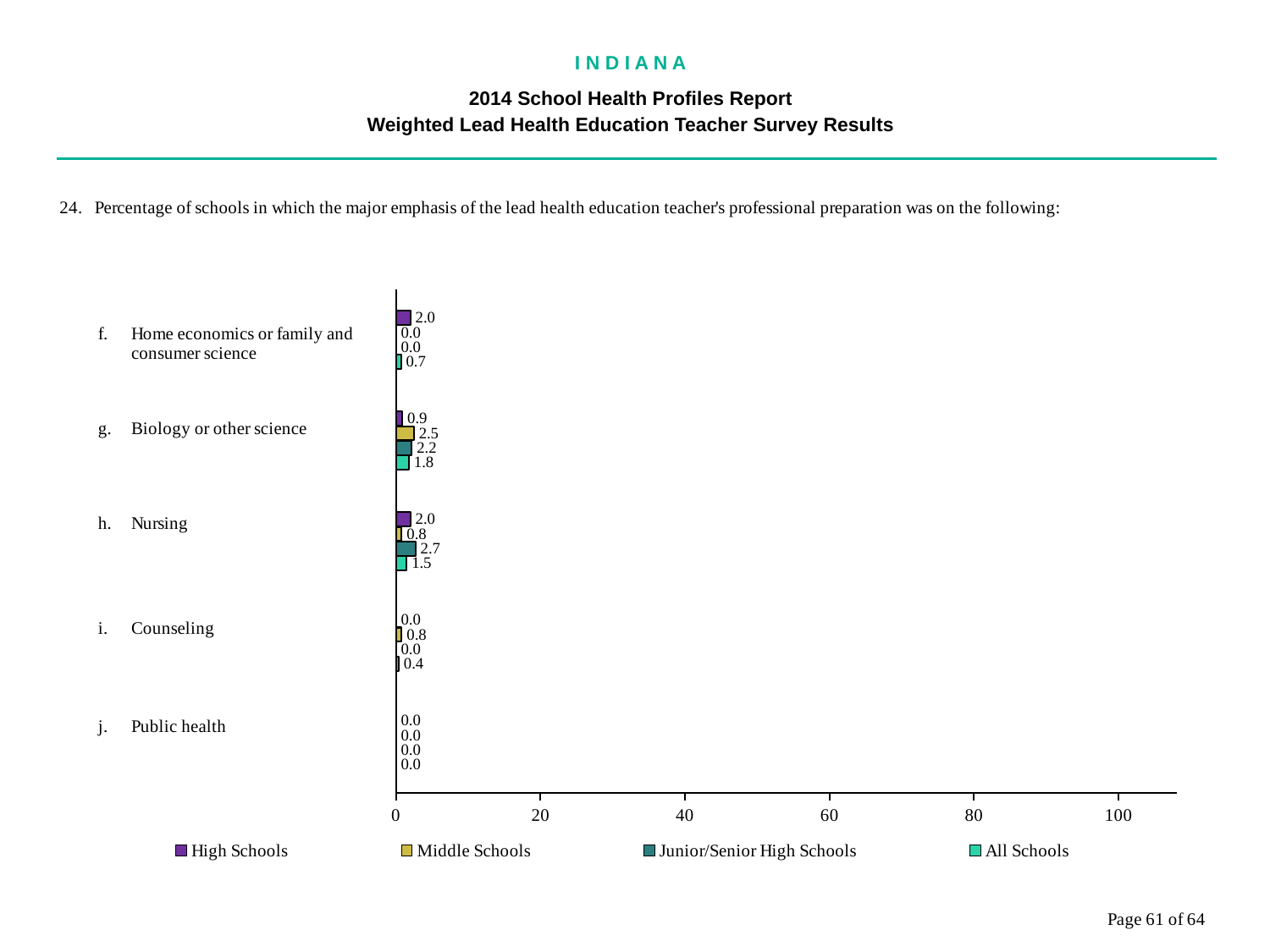
How many series does the legend list? 4 What is the difference between the Middle Schools and High Schools values for Biology or other science? 1.6 Which category has the lowest All Schools value? Public health What is the All Schools value for Counseling? 0.4 How many categories are shown on the chart? 5 What kind of chart is shown on the slide? Bar chart What is the Junior/Senior High Schools value for Nursing? 2.7 What is the Middle Schools value for Biology or other science? 2.5 Which is larger for Nursing: the High Schools value or the Middle Schools value? High Schools Which series has the highest value for Nursing? Junior/Senior High Schools What is the High Schools value for Home economics or family and consumer science? 2.0 What is the highest value shown on the x axis? 100